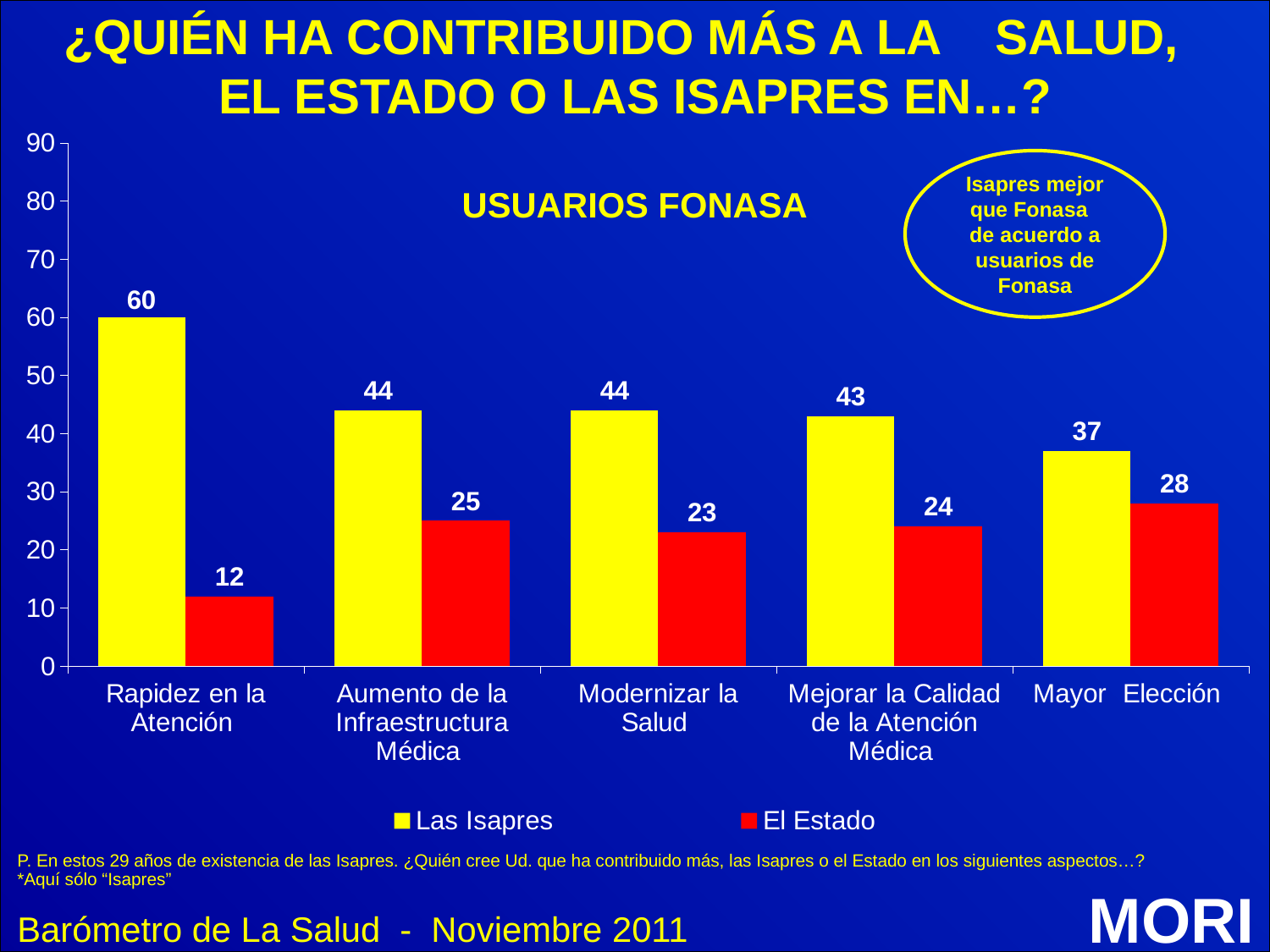
What is the value for El Estado in Mayor Elección? 28 What is the value for Las Isapres in Rapidez en la Atención? 60 In which category is the Las Isapres value highest? Rapidez en la Atención What kind of chart is shown on the slide? Bar chart What is the difference between Las Isapres and El Estado in Rapidez en la Atención? 48 How many categories are shown on the x axis? 5 What is the difference between Las Isapres and El Estado in Mayor Elección? 9 In which category is the El Estado value lowest? Rapidez en la Atención Which is larger in Aumento de la Infraestructura Médica, Las Isapres or El Estado? Las Isapres Which colour represents El Estado in the chart? Red How many series does the legend list? 2 What is the value for El Estado in Modernizar la Salud? 23